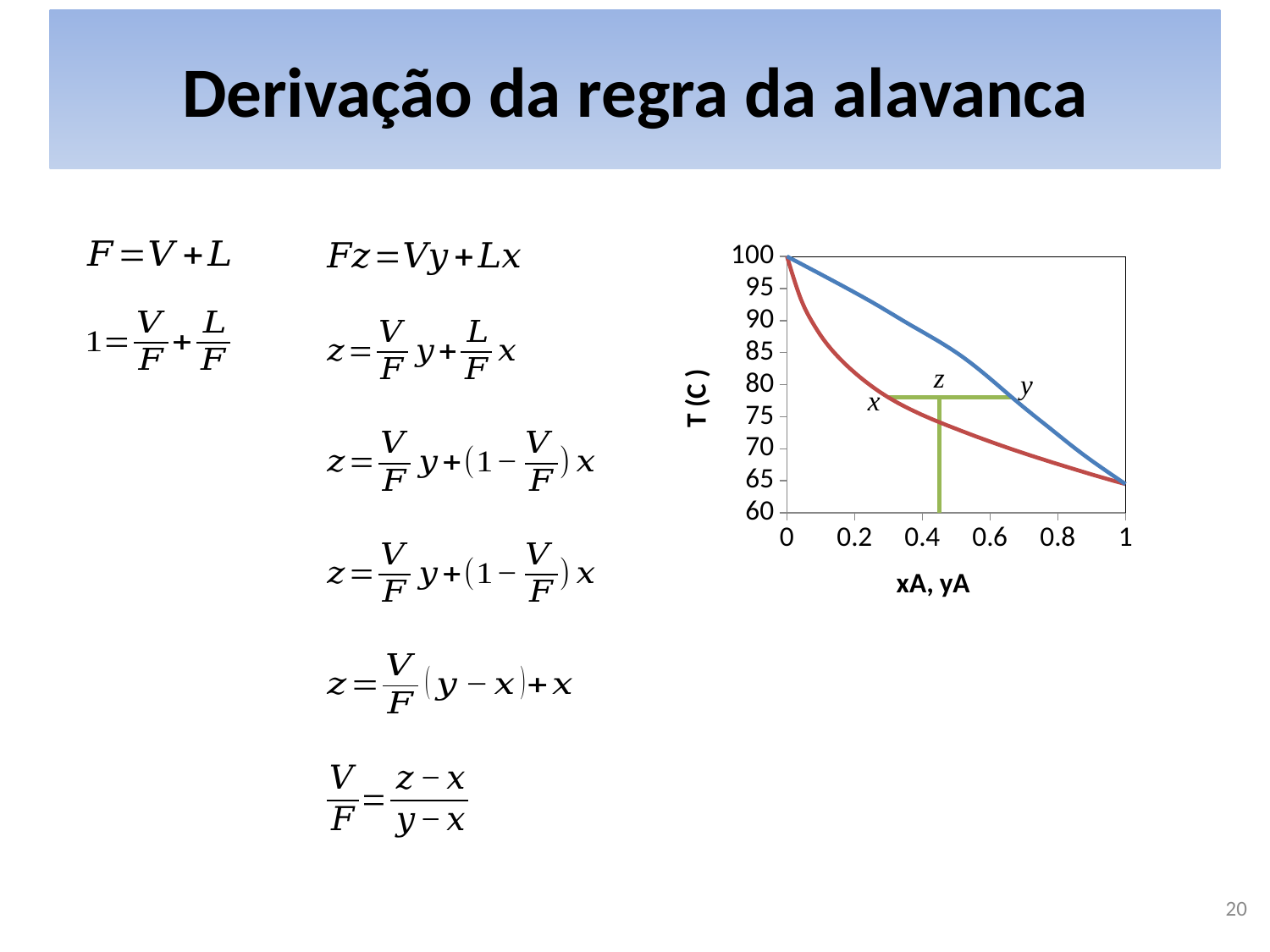
What is the temperature value of the curves at xA = 0? 100 Is the value of the curves at xA = 1 greater or less than 70? less Is the value of the red curve at xA = 0.8 greater or less than 70? less What is the title of the horizontal axis of the chart? xA, yA What is the title of the vertical axis of the chart? T (C) What is the highest value shown on the vertical axis of the chart? 100 Is the value of the blue curve at xA = 0.4 greater or less than 85? greater At xA = 0.4, which curve has the higher temperature, the blue one or the red one? blue Do the blue and red curves rise or fall as xA increases from 0 to 1? fall What kind of chart is shown on the slide? line chart